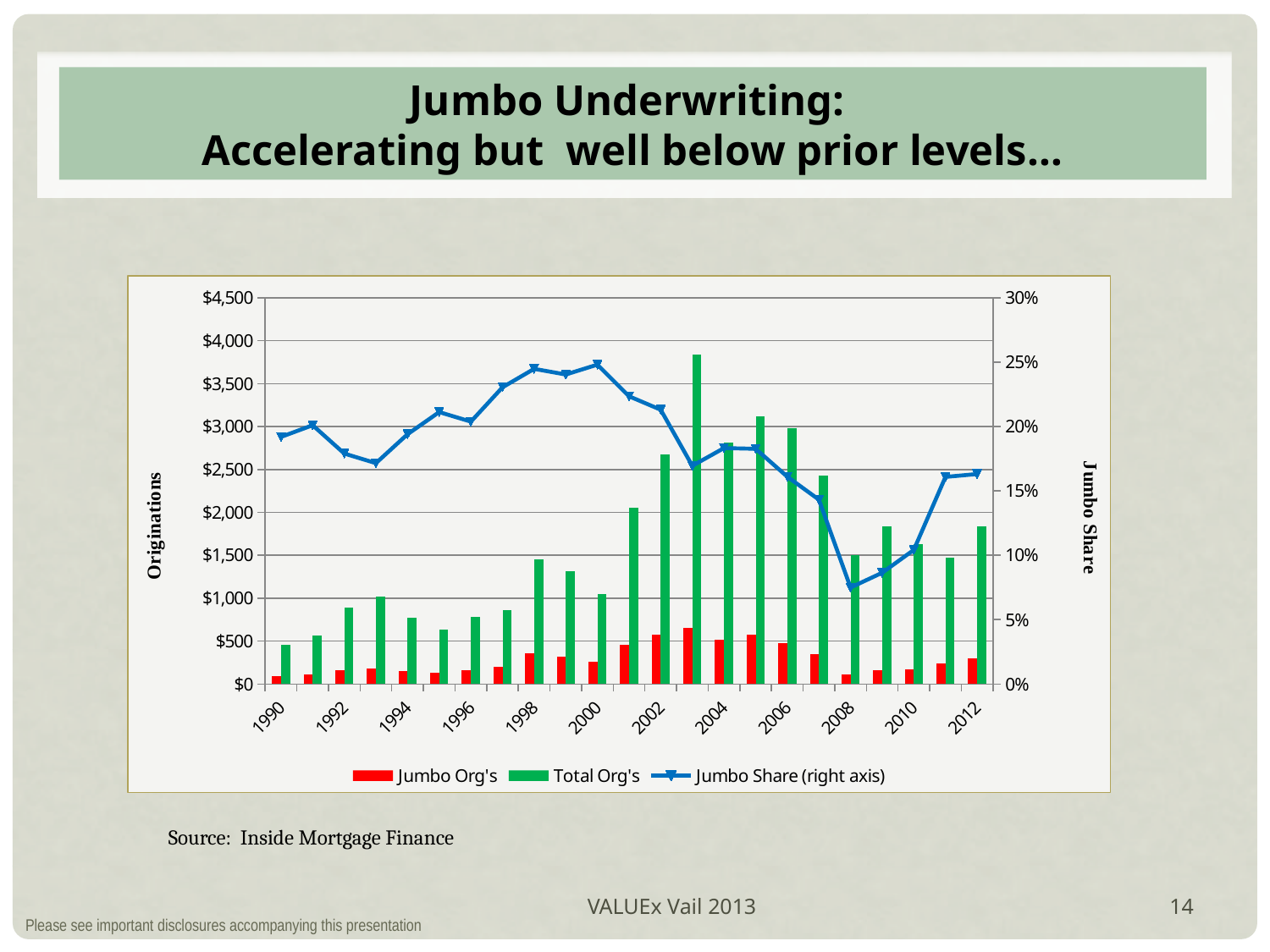
What kind of chart is shown on the slide? Combined bar and line chart How many series does the legend list? 3 Is the Jumbo Share value for 2008 greater or less than 10%? less Is the Jumbo Org's value for 2003 greater or less than $500? greater Which is larger, the Total Org's bar for 2003 or for 2005? 2003 What is the label of the right-hand vertical axis? Jumbo Share Which year has the highest Jumbo Org's bar? 2003 Is the Total Org's value for 2003 greater or less than $3,500? greater In which year is the Jumbo Share line at its lowest point? 2008 Which year has the lowest Total Org's bar? 1990 Does the Jumbo Share line rise or fall from 2005 to 2008? fall Which year has the highest Total Org's bar? 2003